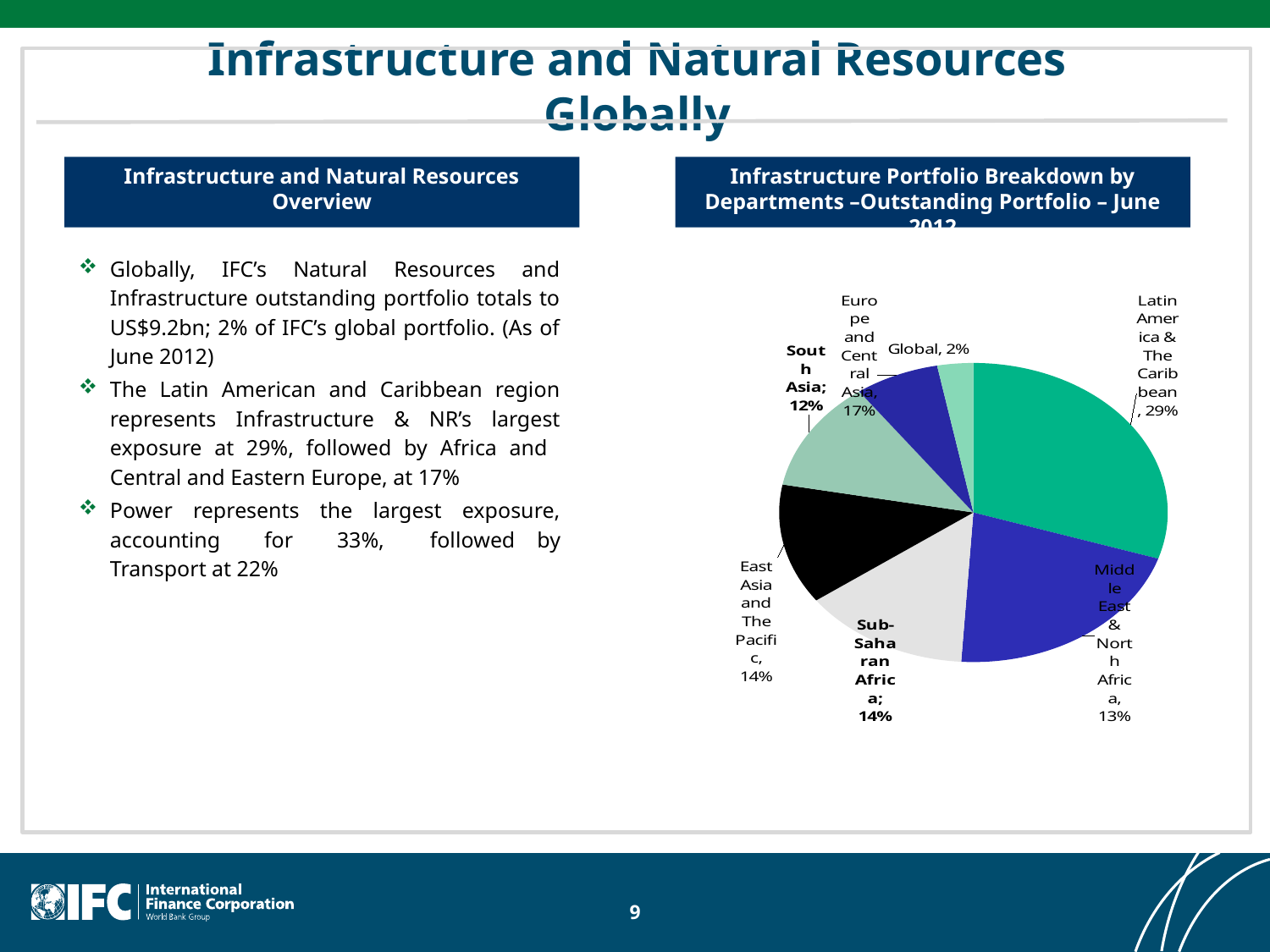
What share of the infrastructure portfolio does South Asia represent? 12% What share of the infrastructure portfolio does Latin America & The Caribbean represent? 29% Which region has the largest share of the infrastructure portfolio? Latin America & The Caribbean What share of the infrastructure portfolio does Europe and Central Asia represent? 17% Which is larger, the share for South Asia or the share for Europe and Central Asia? Europe and Central Asia What is the title of the pie chart? Infrastructure Portfolio Breakdown by Departments – Outstanding Portfolio – June 2012 What type of chart is shown on the slide? pie chart How many slices does the pie chart have? 7 Which slice of the pie chart is the smallest? Global What share of the infrastructure portfolio is labelled Global? 2% What share of the infrastructure portfolio does Middle East & North Africa represent? 13% How many percentage points larger is the Latin America & The Caribbean share than the Europe and Central Asia share? 12